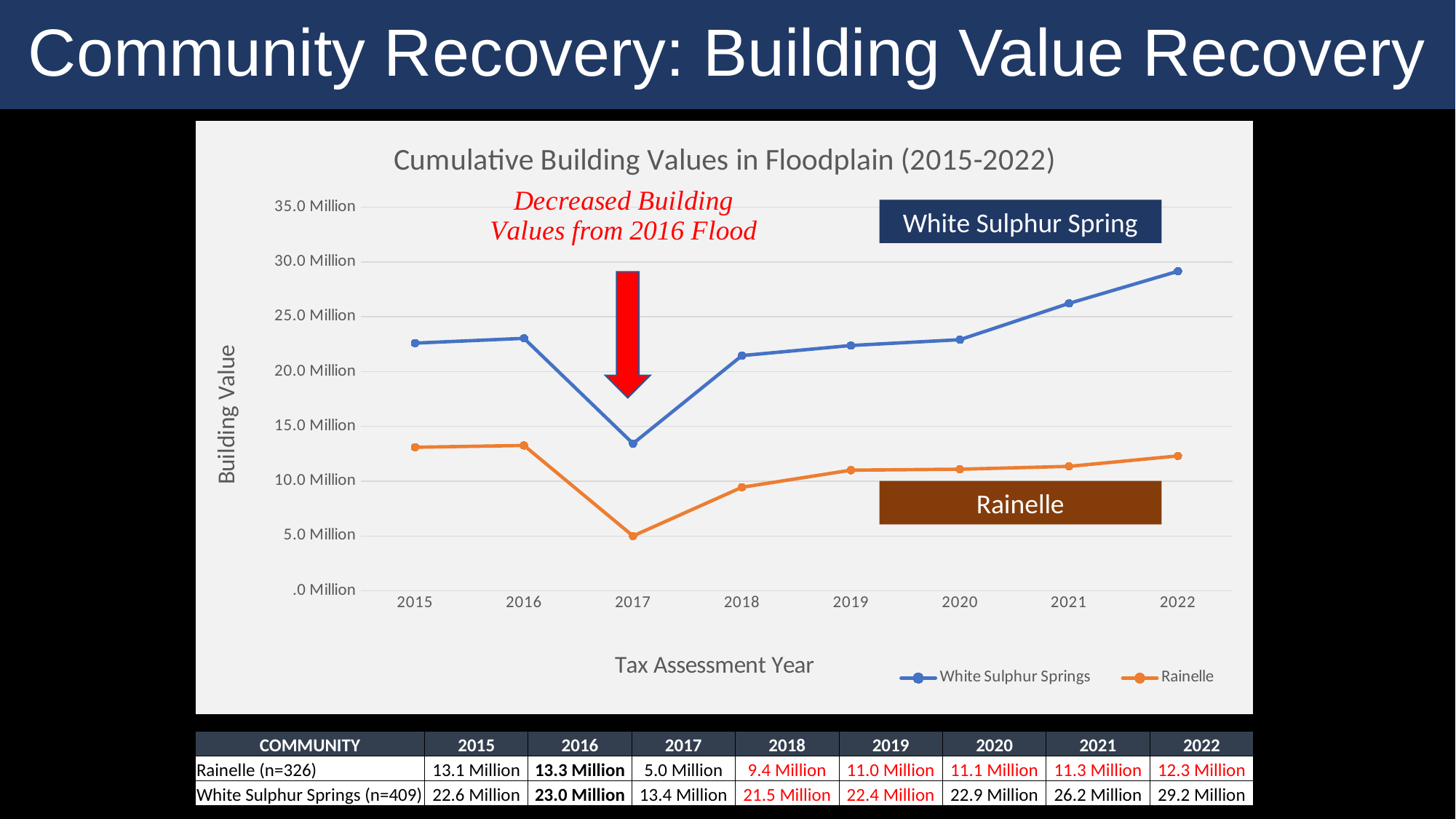
How many years are plotted along the x axis of the chart? 8 In which year is the White Sulphur Springs building value lowest? 2017 Is the White Sulphur Springs building value in 2022 greater or less than 25.0 Million? greater What is the building value for White Sulphur Springs in 2017? 13.4 Million How many series does the chart's legend list? 2 What kind of chart is shown on the slide? Line chart In which year is the Rainelle building value highest? 2016 Do the Rainelle building values rise or fall from 2017 to 2022? Rise Which community has the larger building value in 2019, White Sulphur Springs or Rainelle? White Sulphur Springs What is the building value for Rainelle in 2022? 12.3 Million What is the difference between the White Sulphur Springs building value in 2022 and in 2015? 6.6 Million What is the title of the chart? Cumulative Building Values in Floodplain (2015-2022)